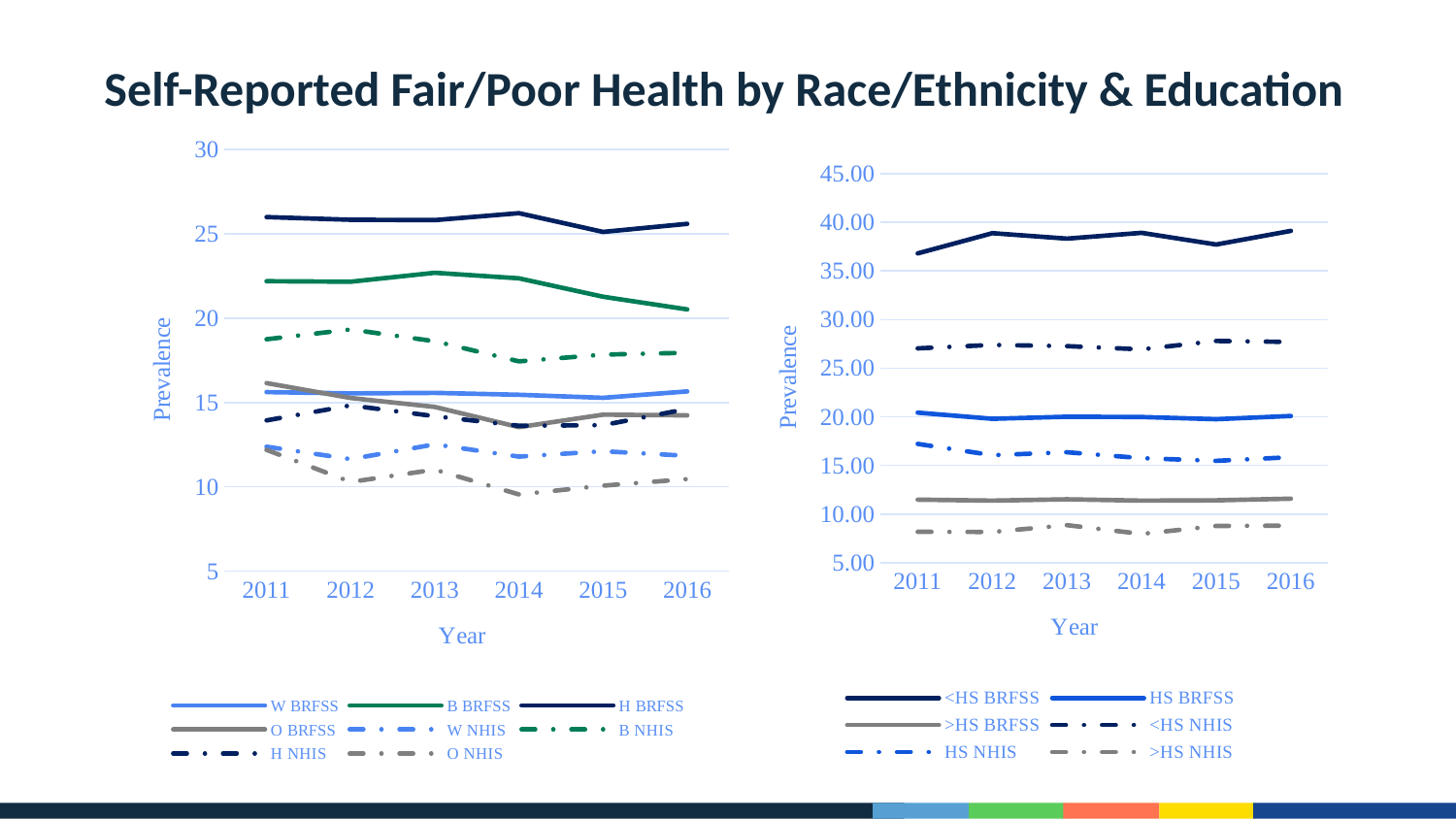
In the left chart, does the B BRFSS line rise or fall from 2013 to 2016? Fall In the right chart, which series has the highest values across all years? <HS BRFSS In the right chart, which is larger in 2016: <HS NHIS or HS NHIS? <HS NHIS In the left chart, which series has the highest values across all years? H BRFSS How many series does the legend of the right chart list? 6 How many years are shown on the x axis of the right chart? 6 In the right chart, is the value for >HS BRFSS in 2013 greater or less than 15.00? less How many series does the legend of the left chart list? 8 In the left chart, is the value for H BRFSS in 2011 greater or less than 25? greater What type of chart is the left chart on the slide? Line chart In the left chart, which series has the lowest values across all years? O NHIS In the right chart, is the value for <HS BRFSS in 2011 greater or less than 35.00? greater